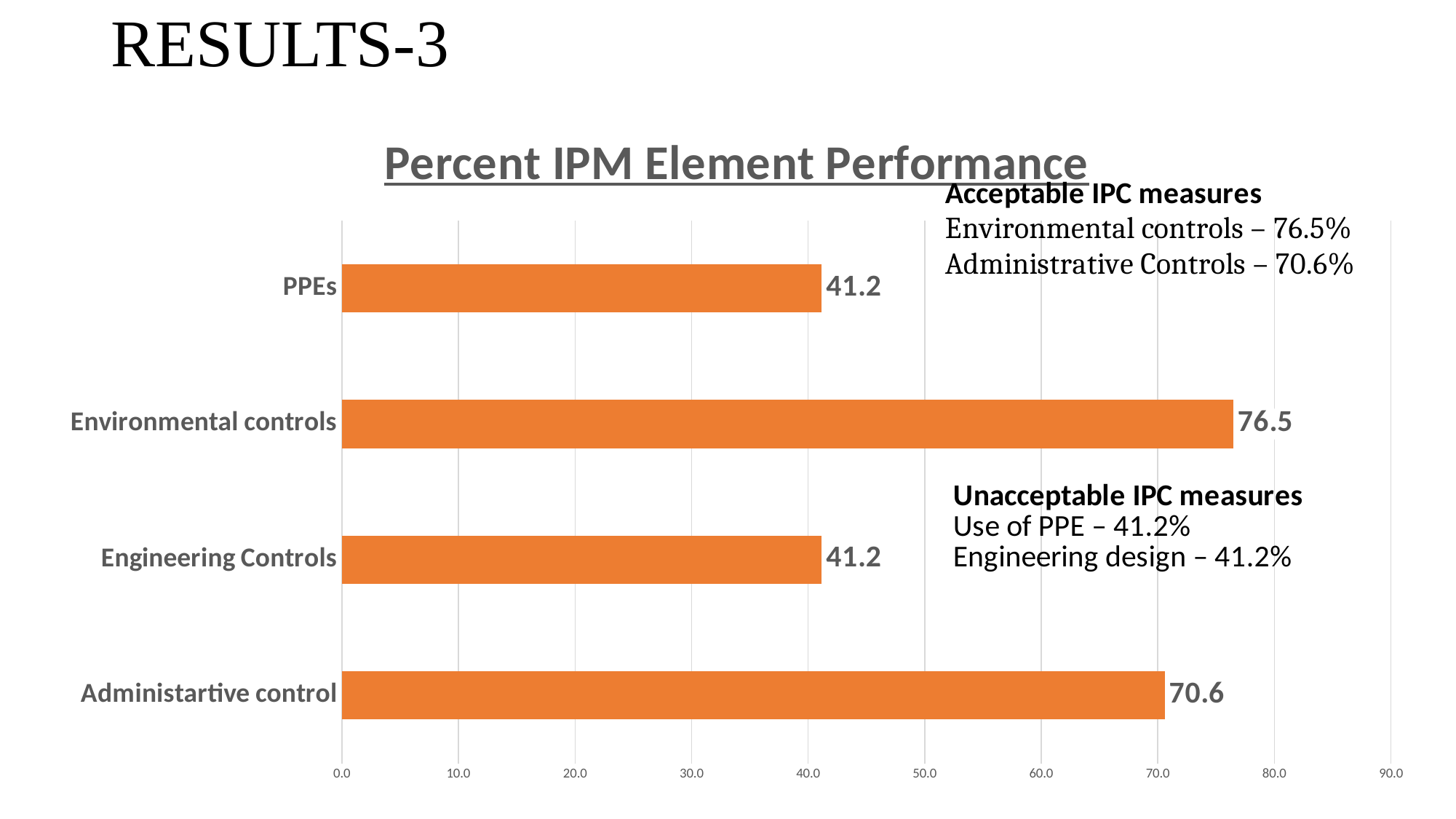
Which category has the highest value? Environmental controls What is the title of the chart? Percent IPM Element Performance What is the difference between the values for Environmental controls and PPEs? 35.3 How many categories are shown in the chart? 4 Which is larger, the value for Administartive control or the value for Engineering Controls? Administartive control What is the value for Administartive control? 70.6 What is the value for Environmental controls? 76.5 What is the value for Engineering Controls? 41.2 Is the value for Administartive control greater or less than 60.0? greater What is the value for PPEs? 41.2 What is the difference between the values for Environmental controls and Administartive control? 5.9 What kind of chart is shown on the slide? Bar chart